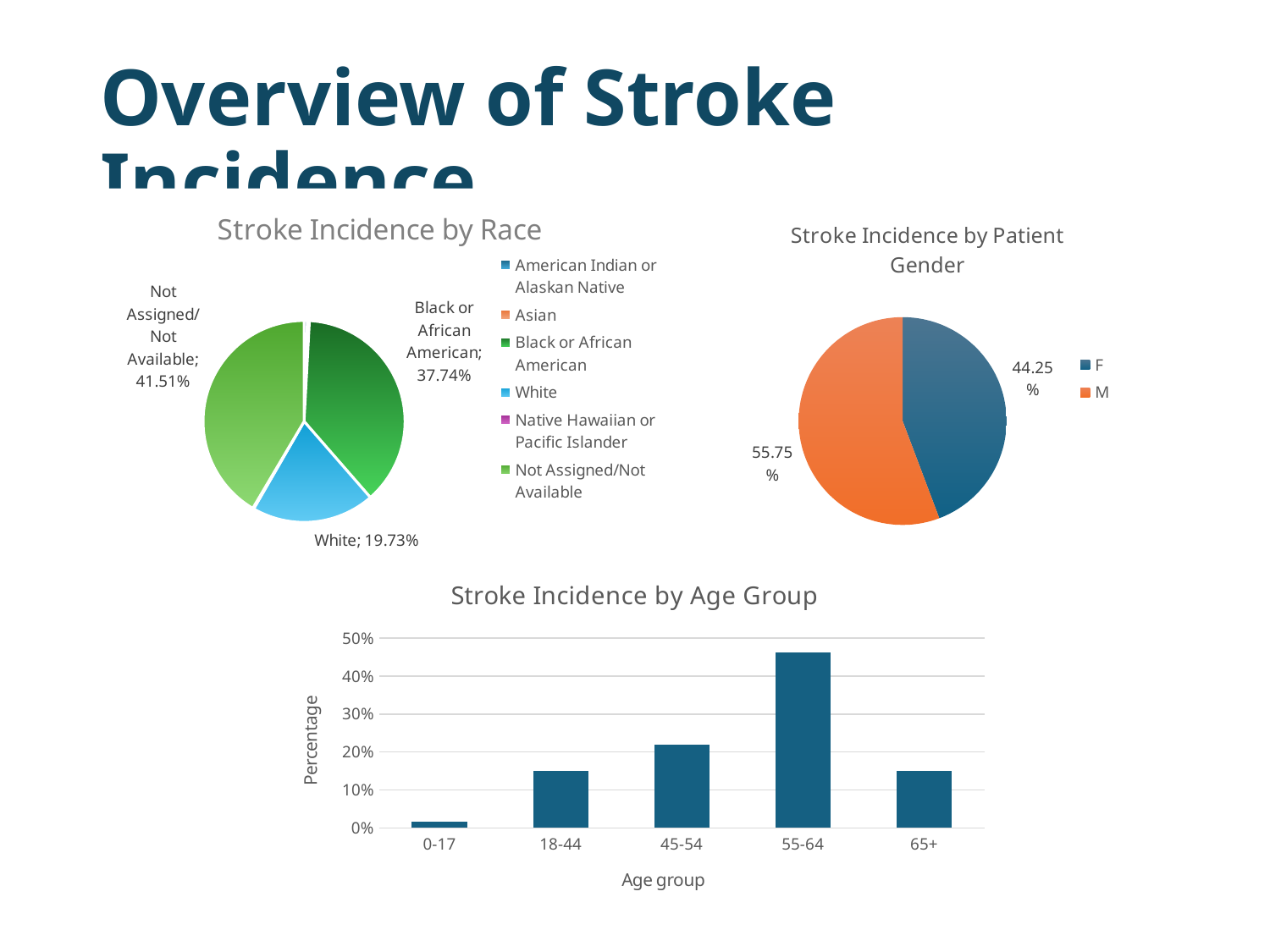
In the Stroke Incidence by Age Group chart, is the value for 55-64 greater or less than 40%? greater In the Stroke Incidence by Age Group chart, which age group has the highest percentage? 55-64 In the Stroke Incidence by Race chart, what percentage is labelled for White? 19.73% What kind of chart is Stroke Incidence by Age Group? bar chart In the Stroke Incidence by Patient Gender chart, what is the difference between the M and F percentages? 11.50% In the Stroke Incidence by Race chart, what percentage is labelled for Not Assigned/Not Available? 41.51% In the Stroke Incidence by Race chart, how many categories does the legend list? 6 In the Stroke Incidence by Patient Gender chart, what percentage is shown for F? 44.25% In the Stroke Incidence by Patient Gender chart, which gender has the larger share? M In the Stroke Incidence by Race chart, what percentage is labelled for Black or African American? 37.74% In the Stroke Incidence by Patient Gender chart, what percentage is shown for M? 55.75% In the Stroke Incidence by Age Group chart, which age group has the lowest percentage? 0-17